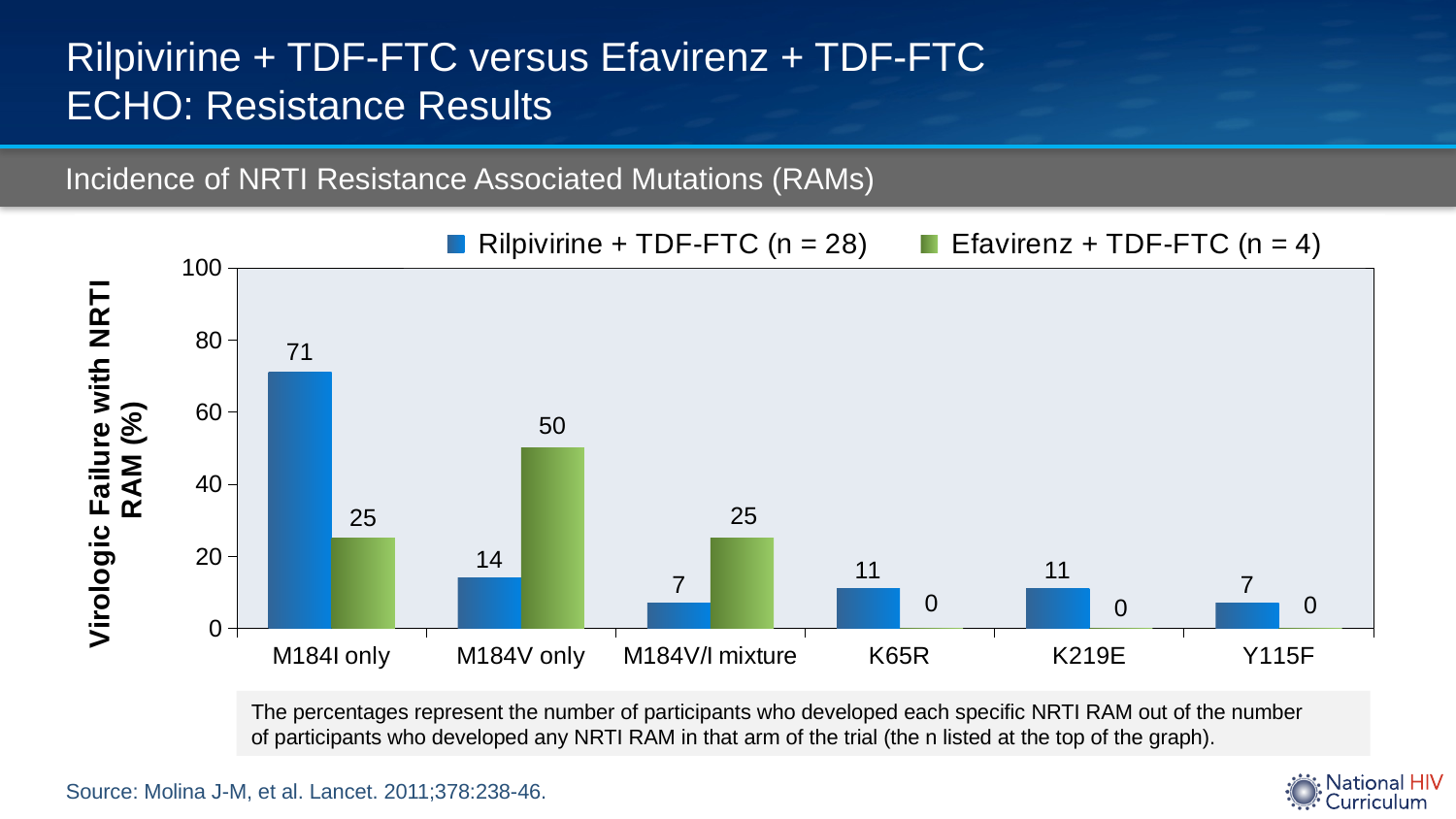
Which category has the highest value in the Rilpivirine + TDF-FTC (n = 28) series? M184I only What is the value for M184I only in the Rilpivirine + TDF-FTC (n = 28) series? 71 For M184V only, which series has the larger value, Rilpivirine + TDF-FTC or Efavirenz + TDF-FTC? Efavirenz + TDF-FTC What is the value for K65R in the Efavirenz + TDF-FTC (n = 4) series? 0 What is the difference between the Rilpivirine + TDF-FTC and Efavirenz + TDF-FTC values for M184I only? 46 How many mutation categories are shown on the x axis? 6 What is the value for M184V only in the Efavirenz + TDF-FTC (n = 4) series? 50 What is the label of the y axis? Virologic Failure with NRTI RAM (%) What kind of chart is shown on the slide? Bar chart How many series does the legend list? 2 Which category has the highest value in the Efavirenz + TDF-FTC (n = 4) series? M184V only What is the value for Y115F in the Rilpivirine + TDF-FTC (n = 28) series? 7